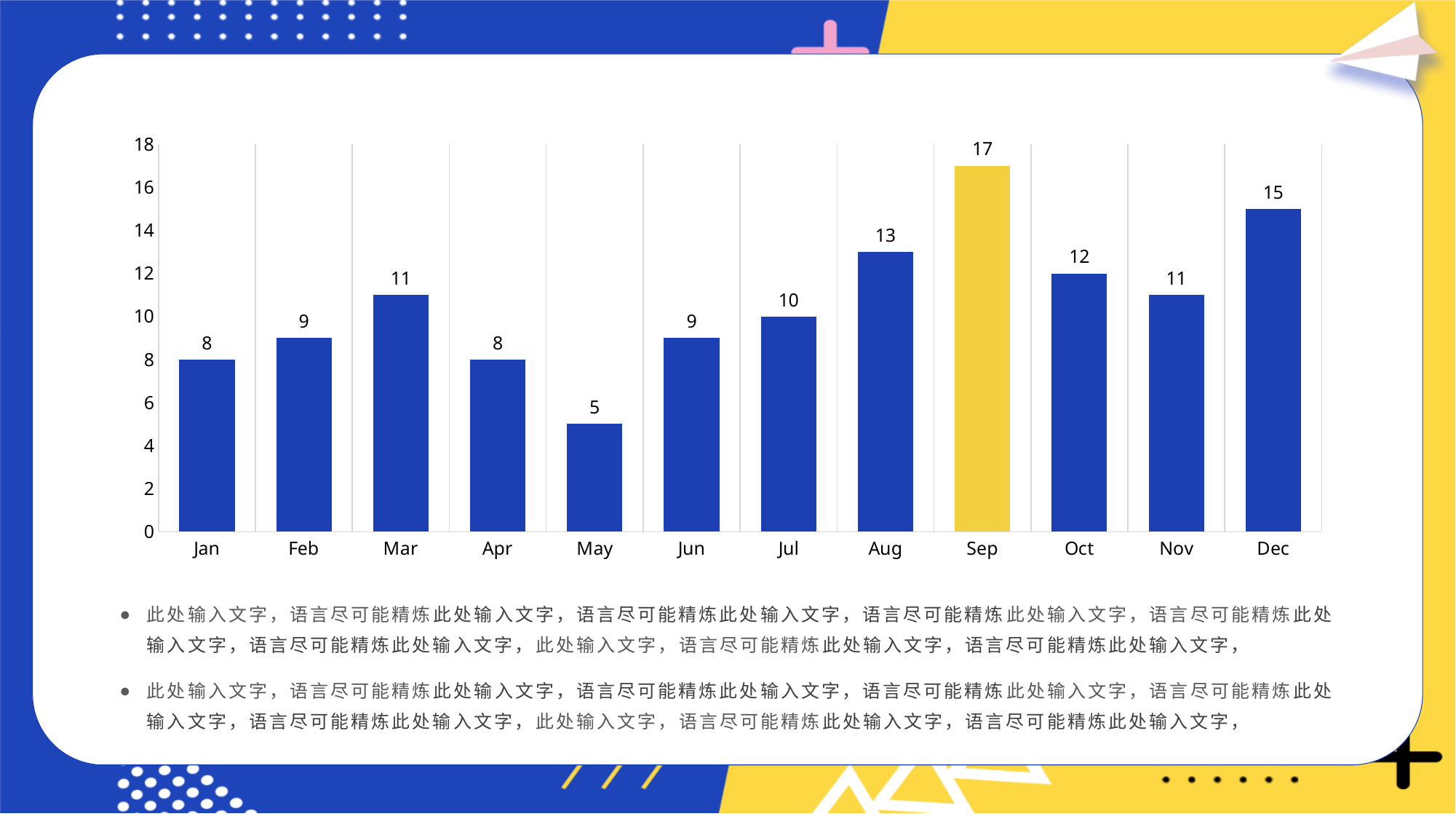
What is the value for May? 5 Which bar is coloured yellow instead of blue? Sep How many months are shown on the x axis? 12 What is the value for Dec? 15 Which is larger, the value for Oct or the value for Jul? Oct Which month has the lowest value? May Do the values rise or fall from May to Sep? Rise What is the value for Sep? 17 What kind of chart is shown on the slide? Bar chart Which month has the highest value? Sep What is the difference between the values for Dec and Aug? 2 What is the difference between the values for Sep and May? 12